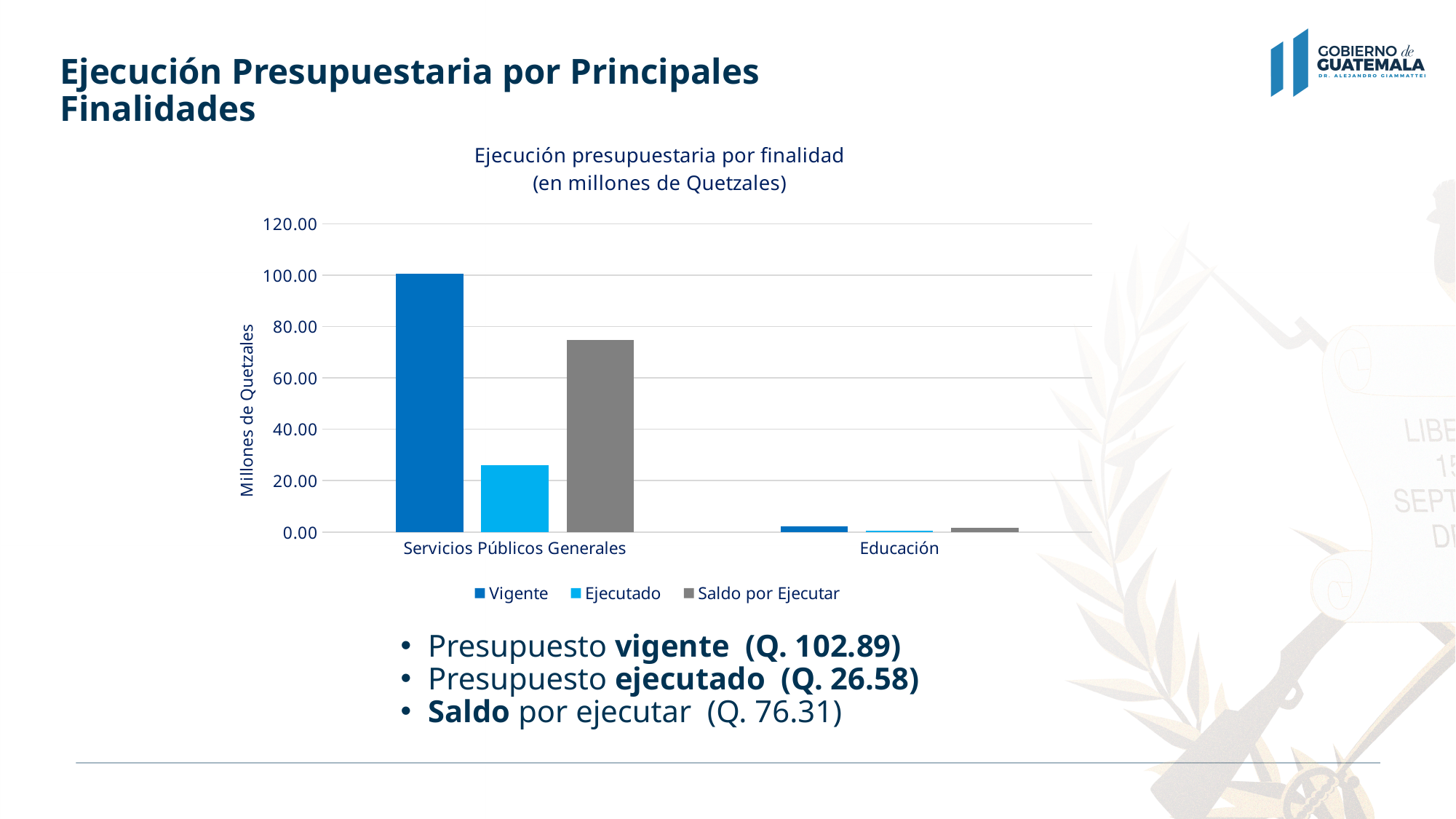
What kind of chart is shown on the slide? bar chart Is the Saldo por Ejecutar value for Servicios Públicos Generales greater or less than 60.00? greater Is the Vigente value for Educación greater or less than 20.00? less What is the title of the chart? Ejecución presupuestaria por finalidad (en millones de Quetzales) For Servicios Públicos Generales, which is larger: the Ejecutado value or the Saldo por Ejecutar value? Saldo por Ejecutar How many categories are shown on the x axis of the chart? 2 Is the Ejecutado value for Servicios Públicos Generales greater or less than 40.00? less How many series does the chart legend list? 3 Which category has the lowest Saldo por Ejecutar value? Educación What is the label on the vertical axis of the chart? Millones de Quetzales Which category has the highest Vigente value? Servicios Públicos Generales